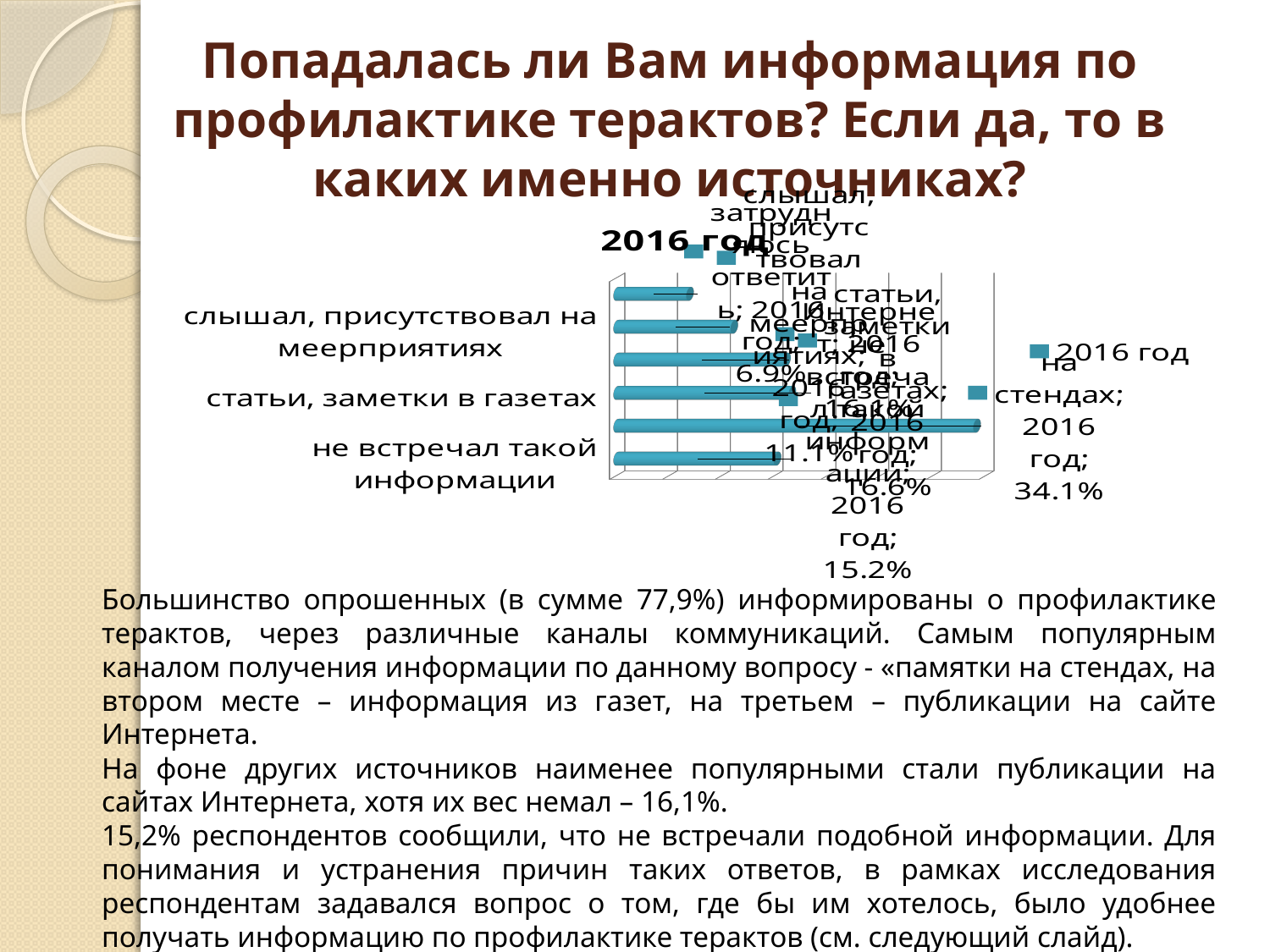
How many bars are plotted in the chart? 6 Which is larger: the value for 'памятки на стендах' or for 'не встречал такой информации'? памятки на стендах Which category has the longest bar in the chart? памятки на стендах What is the value for 'памятки на стендах'? 34.1% What is the difference between the values for 'памятки на стендах' and 'не встречал такой информации'? 18.9% What is the title of the chart? 2016 год What kind of chart is shown on the slide? bar chart What is the value for 'не встречал такой информации'? 15.2% How many series does the chart legend list? 1 What is the legend entry of the chart? 2016 год